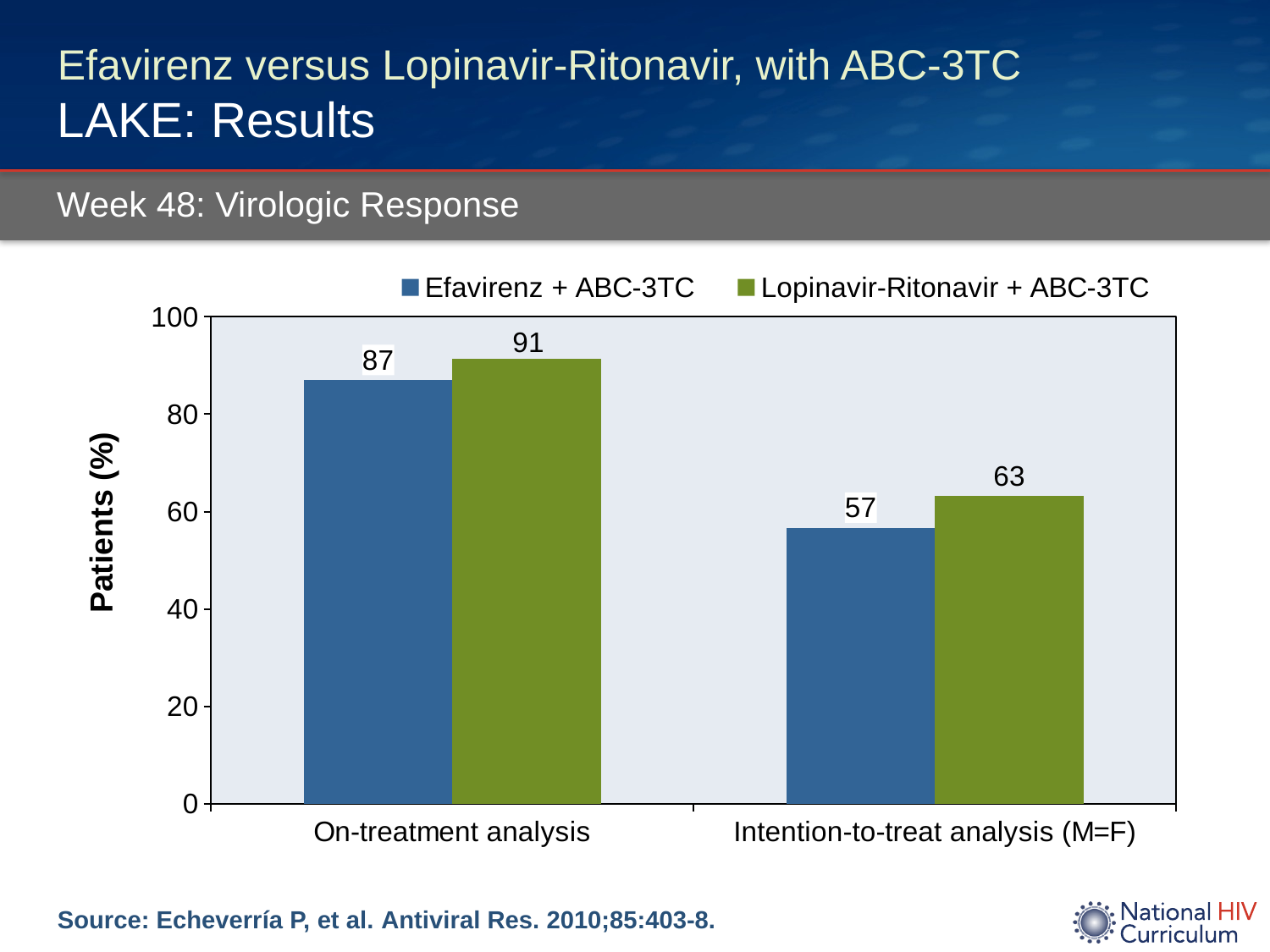
Is the value for Efavirenz + ABC-3TC in the Intention-to-treat analysis (M=F) greater or less than 60? less Which series has the highest value in the On-treatment analysis? Lopinavir-Ritonavir + ABC-3TC What is the value for Efavirenz + ABC-3TC in the On-treatment analysis? 87 Which category has the lowest value for Efavirenz + ABC-3TC? Intention-to-treat analysis (M=F) Which is larger in the Intention-to-treat analysis (M=F): Efavirenz + ABC-3TC or Lopinavir-Ritonavir + ABC-3TC? Lopinavir-Ritonavir + ABC-3TC What is the value for Lopinavir-Ritonavir + ABC-3TC in the Intention-to-treat analysis (M=F)? 63 What is the difference between the On-treatment and Intention-to-treat values for Efavirenz + ABC-3TC? 30 What is the value for Lopinavir-Ritonavir + ABC-3TC in the On-treatment analysis? 91 What is the difference between the Lopinavir-Ritonavir + ABC-3TC and Efavirenz + ABC-3TC values in the Intention-to-treat analysis (M=F)? 6 How many series does the legend list? 2 How many categories are shown on the x axis? 2 What kind of chart is shown on the slide? Bar chart